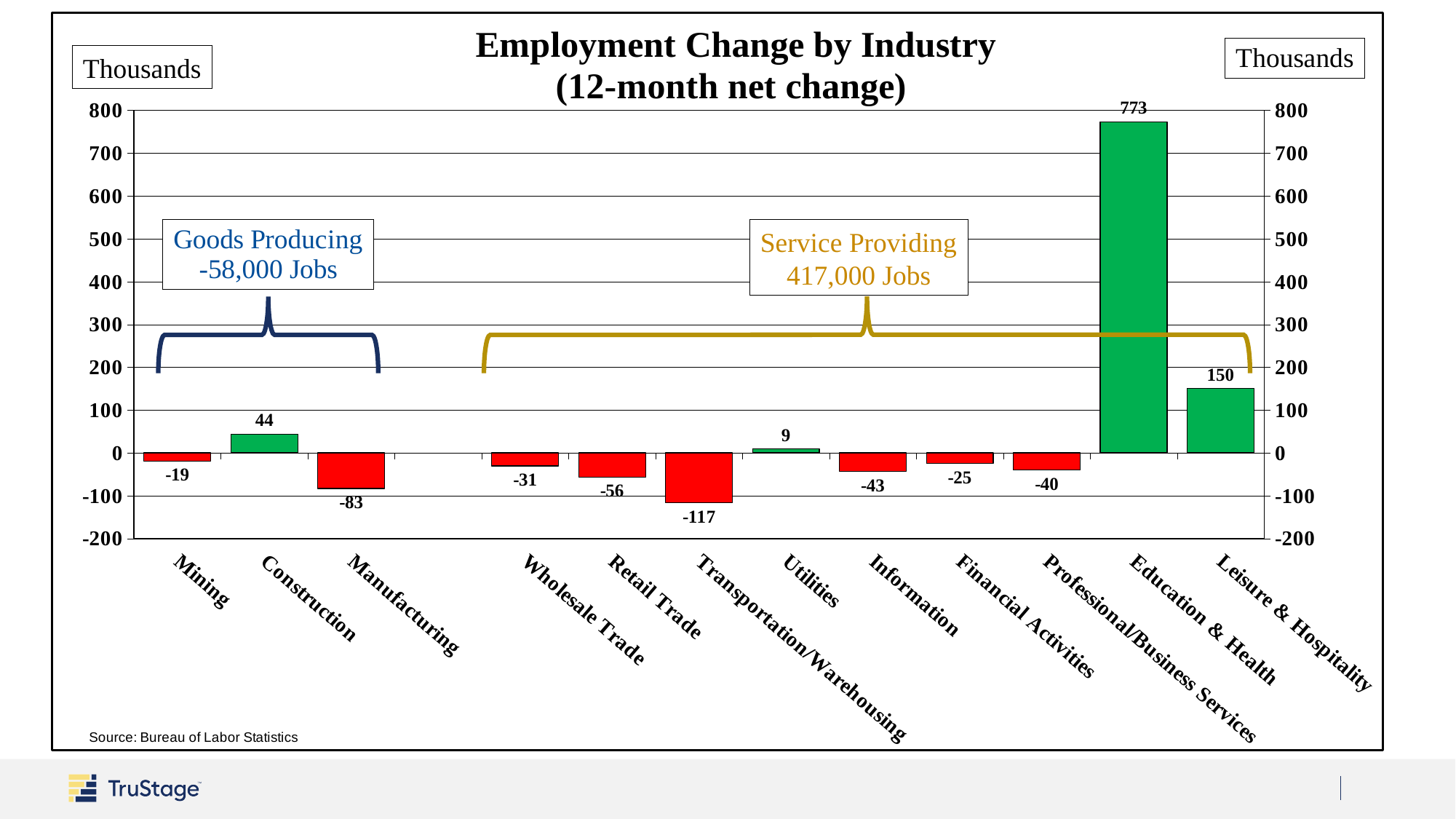
What is the difference between the employment change for Education & Health and Leisure & Hospitality? 623 How many industries are shown on the chart? 12 Which industry has the lowest employment change? Transportation/Warehousing What is the employment change for Transportation/Warehousing? -117 Which industry has the highest employment change? Education & Health According to the annotation, how many jobs did the Service Providing sector add? 417,000 Jobs What is the employment change for Education & Health? 773 What kind of chart is shown on the slide? Bar chart What is the title of the chart? Employment Change by Industry (12-month net change) What is the employment change for Leisure & Hospitality? 150 Which has a larger employment change, Retail Trade or Wholesale Trade? Wholesale Trade What is the employment change for Construction? 44